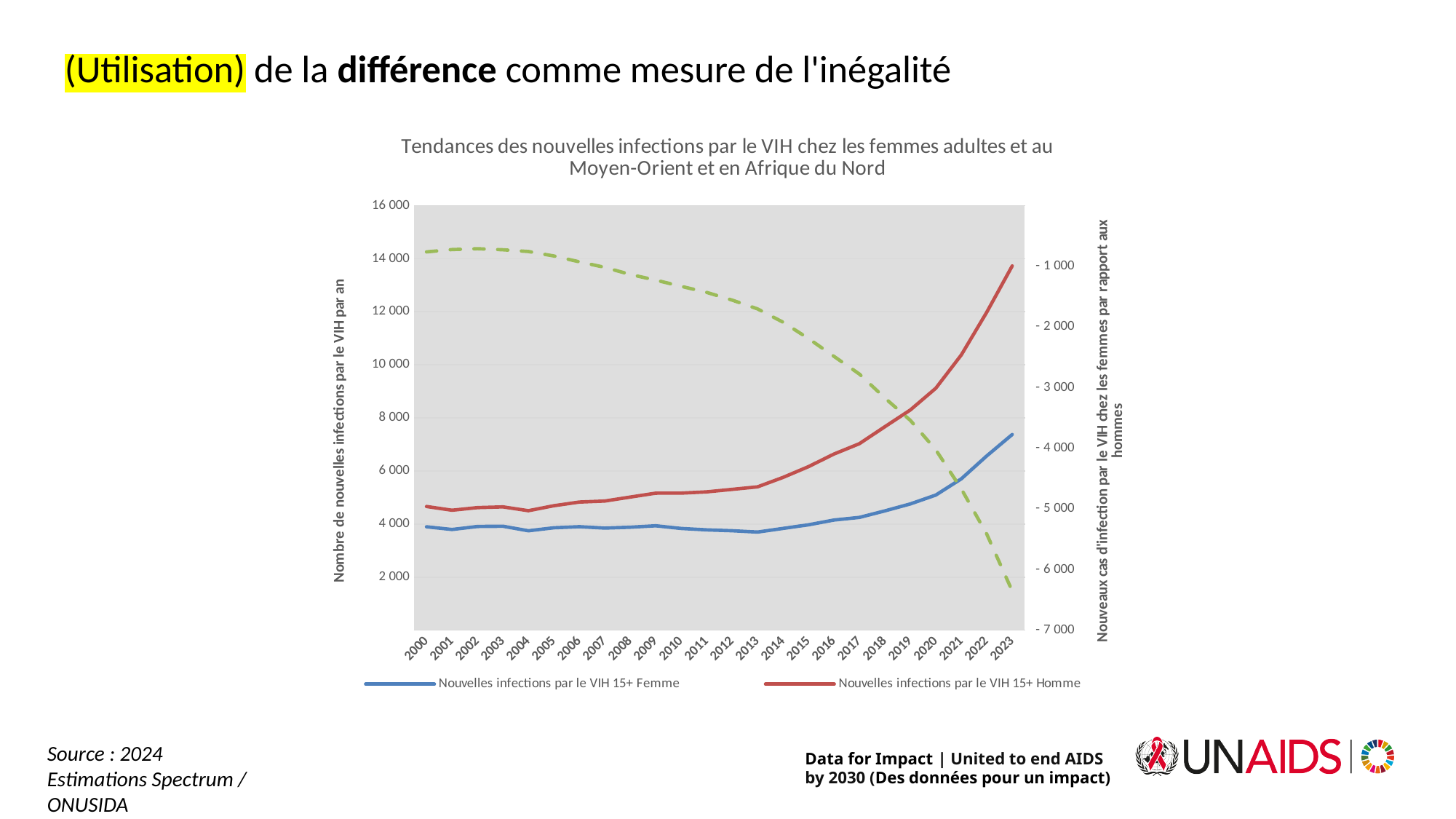
Does the line for 'Nouvelles infections par le VIH 15+ Femme' rise or fall between 2015 and 2023? rise How many years are plotted along the x axis of the chart? 24 Does the line for 'Nouvelles infections par le VIH 15+ Homme' rise or fall between 2013 and 2023? rise Is the value for 'Nouvelles infections par le VIH 15+ Homme' in 2020 greater or less than 8 000? greater How many series does the chart legend list? 2 Is the value for 'Nouvelles infections par le VIH 15+ Femme' in 2023 greater or less than 6 000? greater What kind of chart is shown on the slide? line chart Is the value for 'Nouvelles infections par le VIH 15+ Homme' in 2023 greater or less than 12 000? greater In which year does the 'Nouvelles infections par le VIH 15+ Homme' series reach its highest value? 2023 In 2023, which series has the larger value: 'Nouvelles infections par le VIH 15+ Femme' or 'Nouvelles infections par le VIH 15+ Homme'? Nouvelles infections par le VIH 15+ Homme What colour is the line for 'Nouvelles infections par le VIH 15+ Femme'? blue